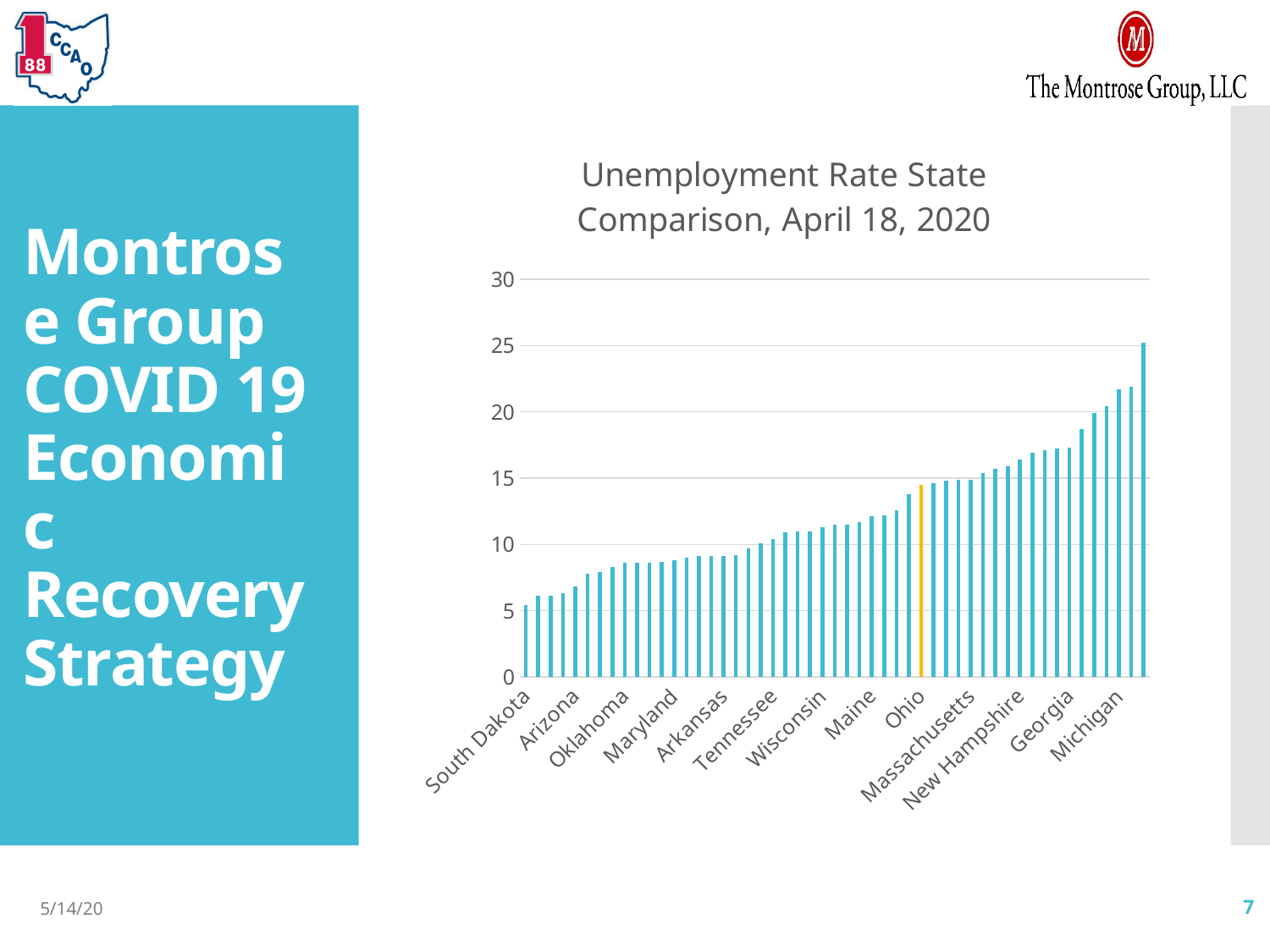
Is the value for Georgia greater or less than 15? greater Is the value for Ohio greater or less than 10? greater Is the value for Maine greater or less than 10? greater Which has the larger value, Michigan or South Dakota? Michigan Which has the larger value, Ohio or Arizona? Ohio Do the bar values rise or fall moving from left to right along the x axis? rise Which state's bar is highlighted in a different colour (orange) from the rest? Ohio What kind of chart is shown on the slide? bar chart What is the title of the chart? Unemployment Rate State Comparison, April 18, 2020